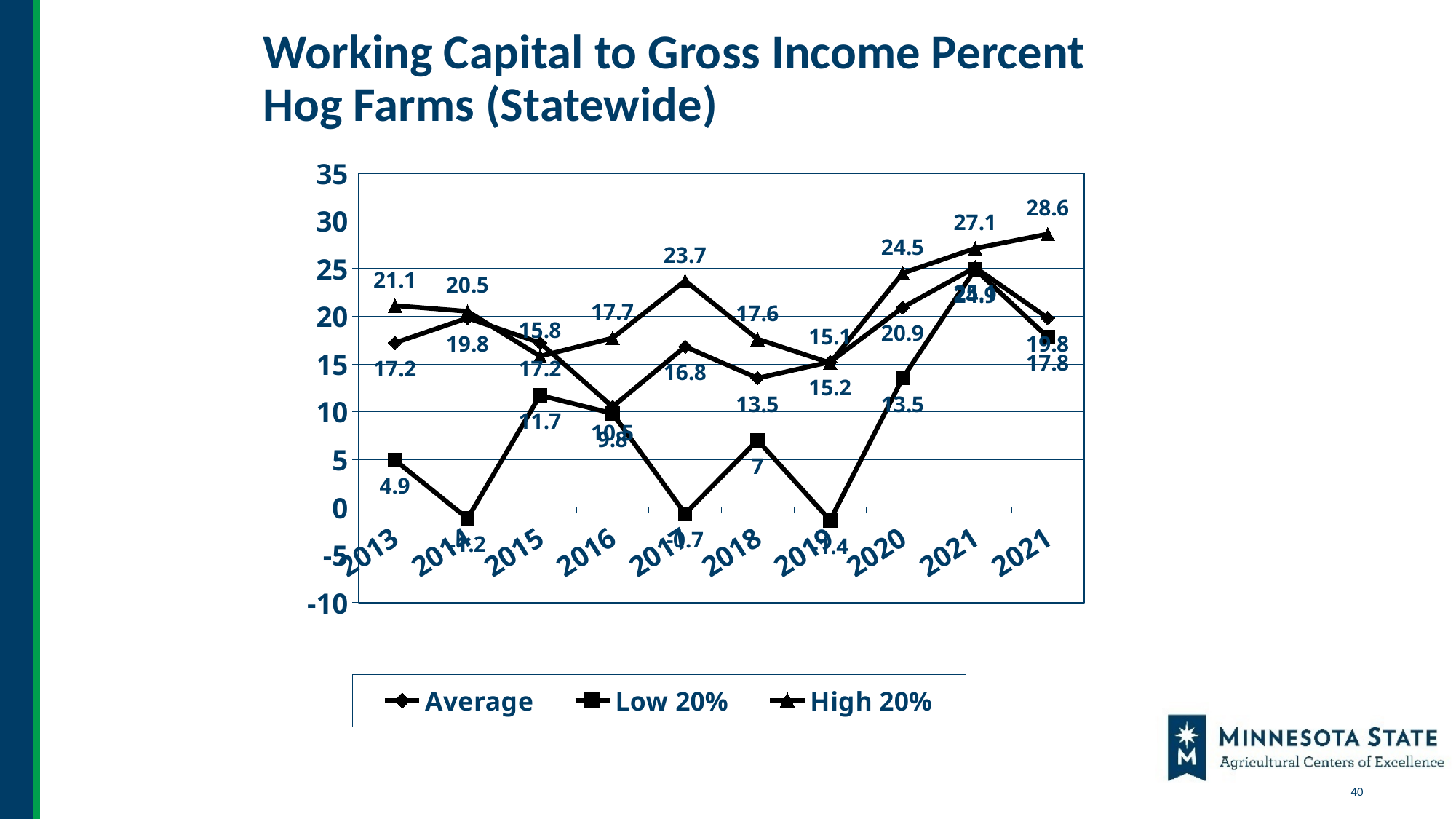
What is the Low 20% value for 2018? 7 How many data points does each series have along the x axis? 10 What is the Average value for 2016? 10.5 How many series does the legend list? 3 Is the Low 20% value for 2015 greater or less than 10? greater What is the difference between the High 20% and Average values in 2017? 6.9 What is the highest value reached by the High 20% series? 28.6 What is the Low 20% value for 2013? 4.9 In 2020, which is larger: the Average value or the Low 20% value? Average What kind of chart is shown on the slide? line chart What is the High 20% value for 2013? 21.1 Does the High 20% series rise or fall from 2019 to the final point? rise